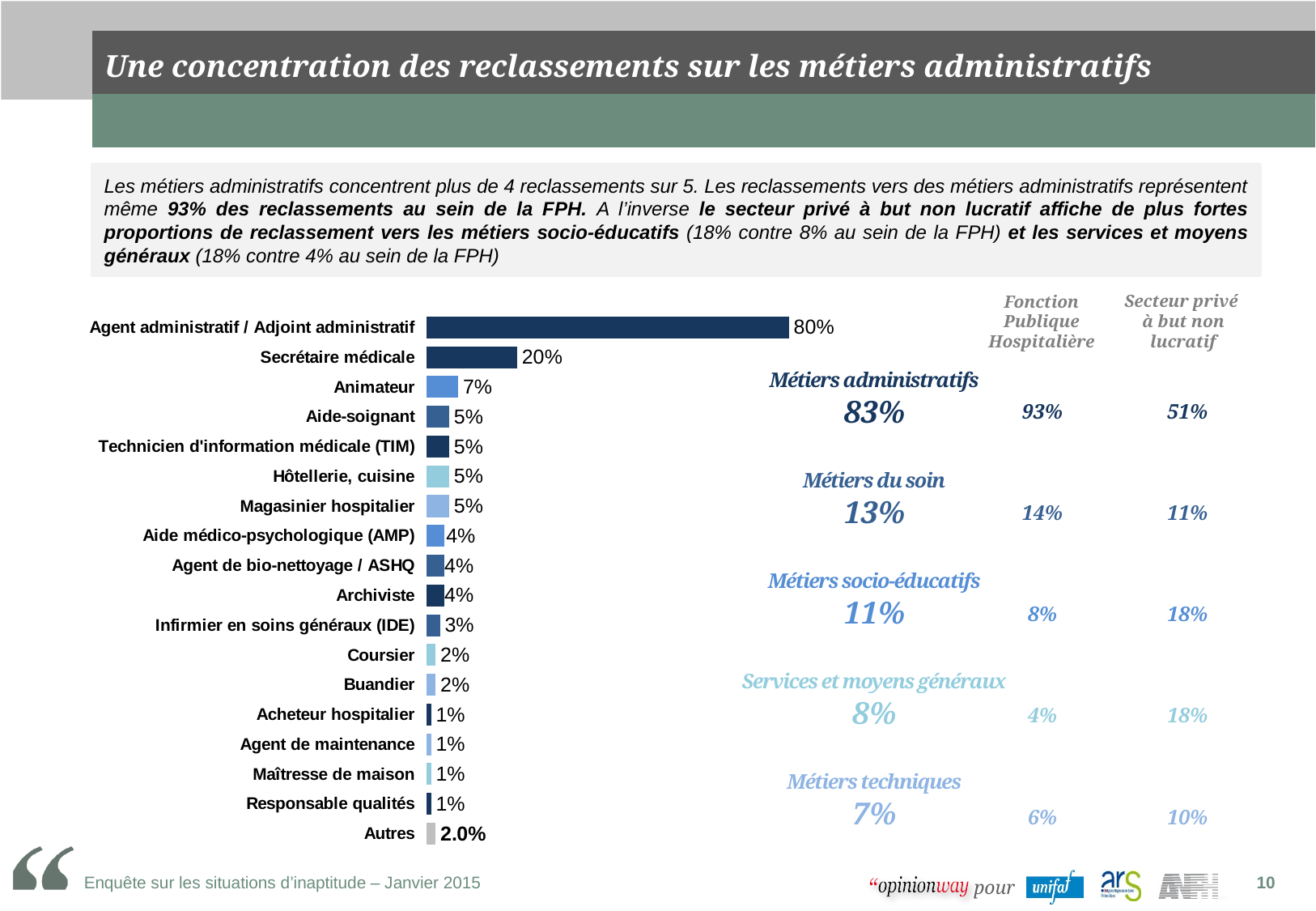
Which is larger, the value for Archiviste or the value for Coursier? Archiviste What is the value for Animateur? 7% What is the value for Infirmier en soins généraux (IDE)? 3% What kind of chart is shown on the slide? bar chart What is the value for Secrétaire médicale? 20% Which is larger, the value for Animateur or the value for Aide-soignant? Animateur What is the value for Agent administratif / Adjoint administratif? 80% Do the bar values increase or decrease going from the top category to the bottom category (excluding Autres)? decrease What is the value for Autres? 2.0% What is the difference between the values for Agent administratif / Adjoint administratif and Secrétaire médicale? 60 percentage points How many categories are plotted in the bar chart? 18 Which category has the highest value? Agent administratif / Adjoint administratif